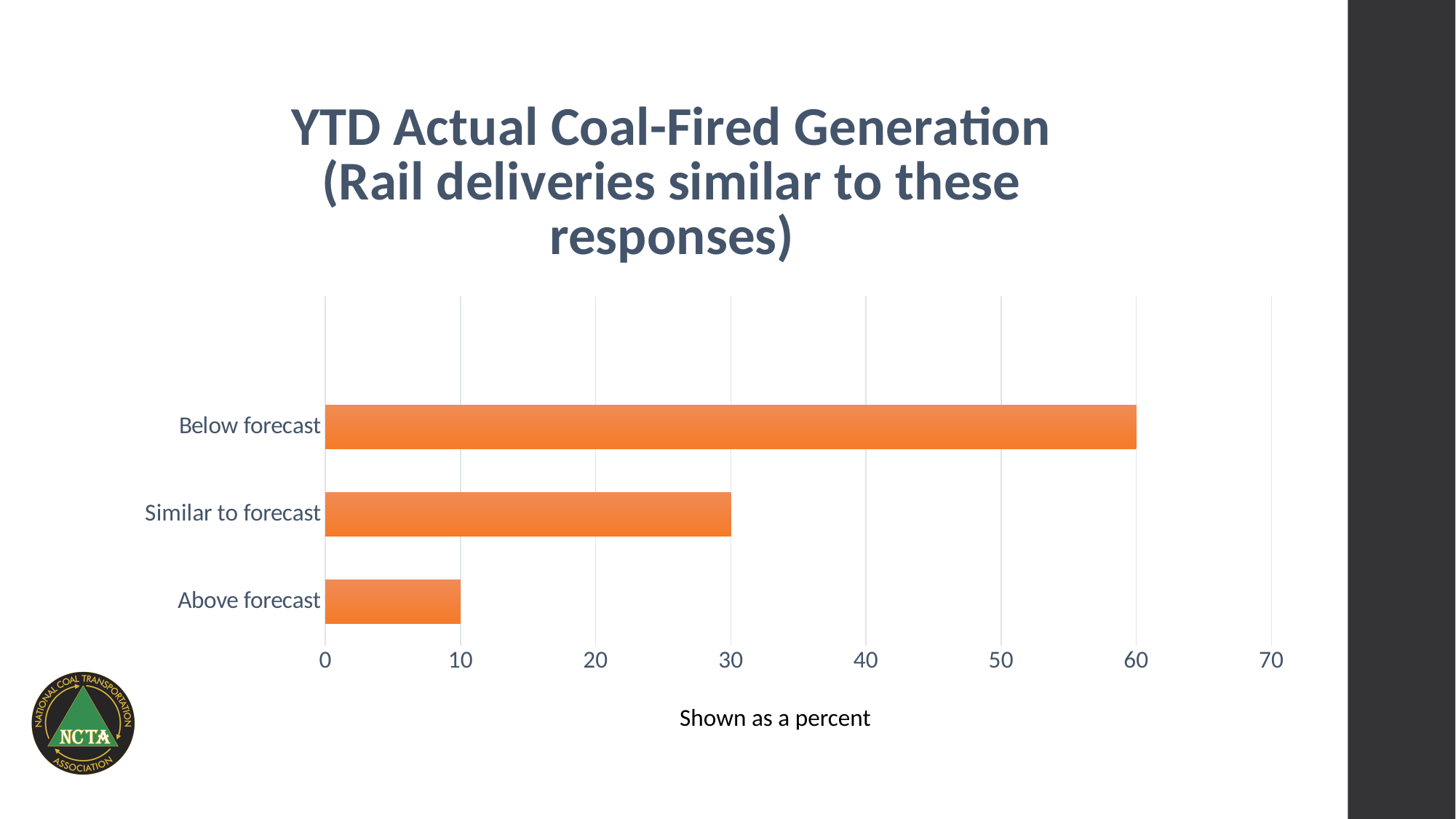
Which is larger, the value for Similar to forecast or the value for Above forecast? Similar to forecast Is the value for Below forecast greater or less than 50? greater How many categories are shown in the chart? 3 What is the value for Above forecast? 10 What is the difference between the values for Similar to forecast and Above forecast? 20 What is the value for Below forecast? 60 Which category has the highest value? Below forecast What kind of chart is shown on the slide? bar chart What unit does the note below the axis say the values are shown in? percent What is the difference between the values for Below forecast and Similar to forecast? 30 Which category has the lowest value? Above forecast What is the value for Similar to forecast? 30